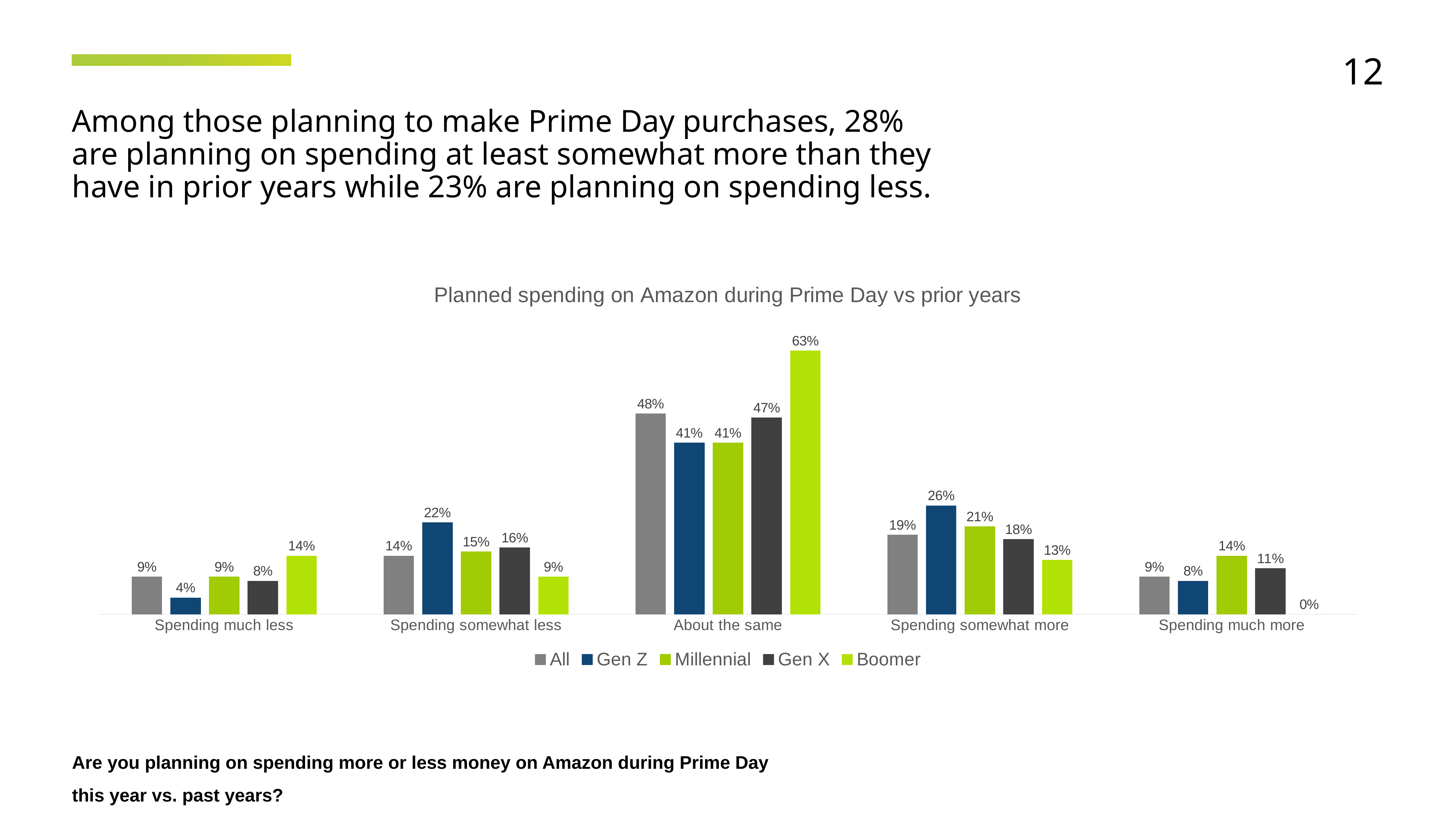
What is the value for Millennial in the 'Spending somewhat more' category? 21% What is the value for Boomer in the 'About the same' category? 63% Which series has the highest value in the 'About the same' category? Boomer What is the difference between the Gen Z and Boomer values in the 'Spending somewhat more' category? 13% What is the title of the chart? Planned spending on Amazon during Prime Day vs prior years How many series does the legend list? 5 How many categories are shown on the x axis? 5 Which is larger in the 'Spending somewhat less' category: Gen Z or Gen X? Gen Z What kind of chart is shown on the slide? Bar chart What is the value for Gen Z in the 'Spending much less' category? 4% Which series has the lowest value in the 'Spending much less' category? Gen Z What is the value for Boomer in the 'Spending much more' category? 0%